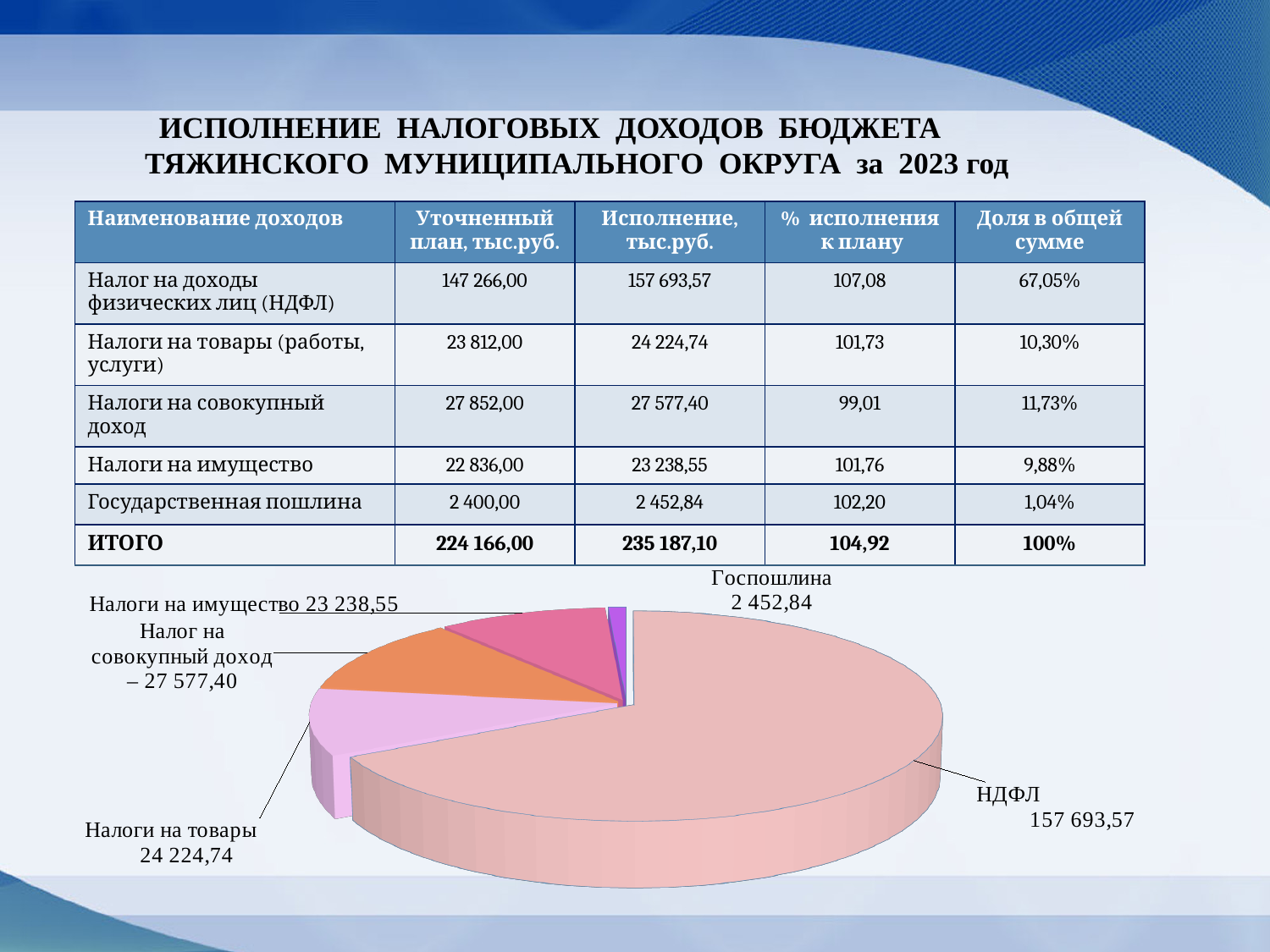
In the pie chart, what is the difference between the values for Налоги на товары and Налоги на имущество? 986,19 In the pie chart, what is the value for Налог на совокупный доход? 27 577,40 In the pie chart, what is the difference between the values for Налог на совокупный доход and Налоги на товары? 3 352,66 What kind of chart is shown at the bottom of the slide? pie chart How many slices does the pie chart have? 5 In the pie chart, what is the value for НДФЛ? 157 693,57 Which slice of the pie chart is the largest? НДФЛ In the pie chart, what is the value for Налоги на товары? 24 224,74 In the pie chart, what is the value for Налоги на имущество? 23 238,55 In the pie chart, which is larger: Налог на совокупный доход or Налоги на имущество? Налог на совокупный доход In the pie chart, what is the value for Госпошлина? 2 452,84 Which slice of the pie chart is the smallest? Госпошлина